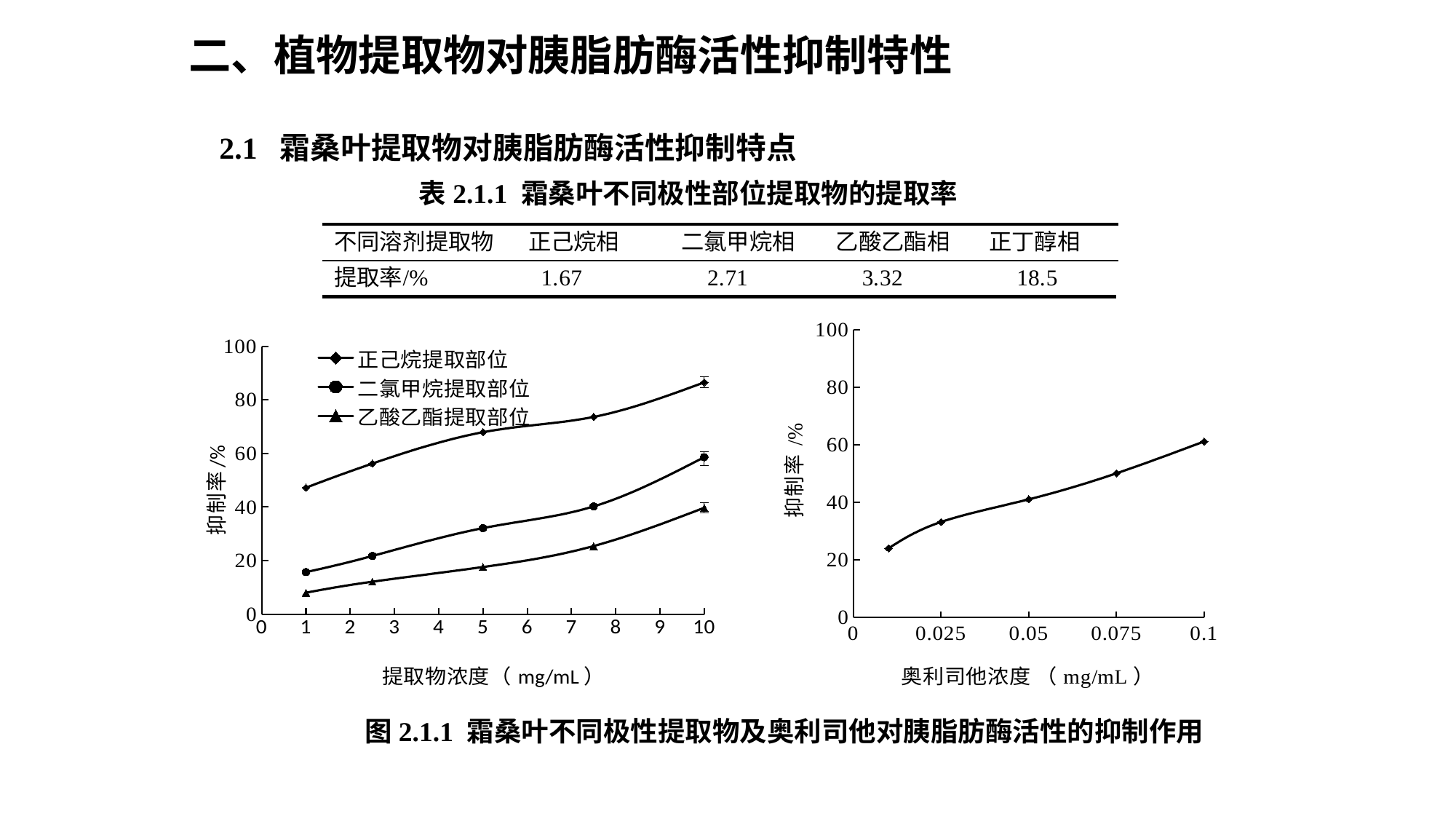
In the left chart, is the 抑制率 for 二氯甲烷提取部位 at 1 mg/mL greater or less than 20? less How many series does the legend of the left chart list? 3 In the left chart, is the 抑制率 for 正己烷提取部位 at 1 mg/mL greater or less than 40? greater In the right chart, is the 抑制率 at 0.025 mg/mL greater or less than 20? greater In the left chart, does the 抑制率 for 乙酸乙酯提取部位 rise or fall as 提取物浓度 increases? rise In the left chart, at 10 mg/mL, which is larger: the 抑制率 for 二氯甲烷提取部位 or for 乙酸乙酯提取部位? 二氯甲烷提取部位 In the left chart, which series has the highest 抑制率 at 10 mg/mL? 正己烷提取部位 What is the x-axis label of the right chart? 奥利司他浓度（mg/mL） In the left chart, which series has the lowest 抑制率 at 1 mg/mL? 乙酸乙酯提取部位 What kind of chart is the left chart (提取物浓度 on the x axis)? line chart How many data points are plotted in the right chart (奥利司他浓度 on the x axis)? 5